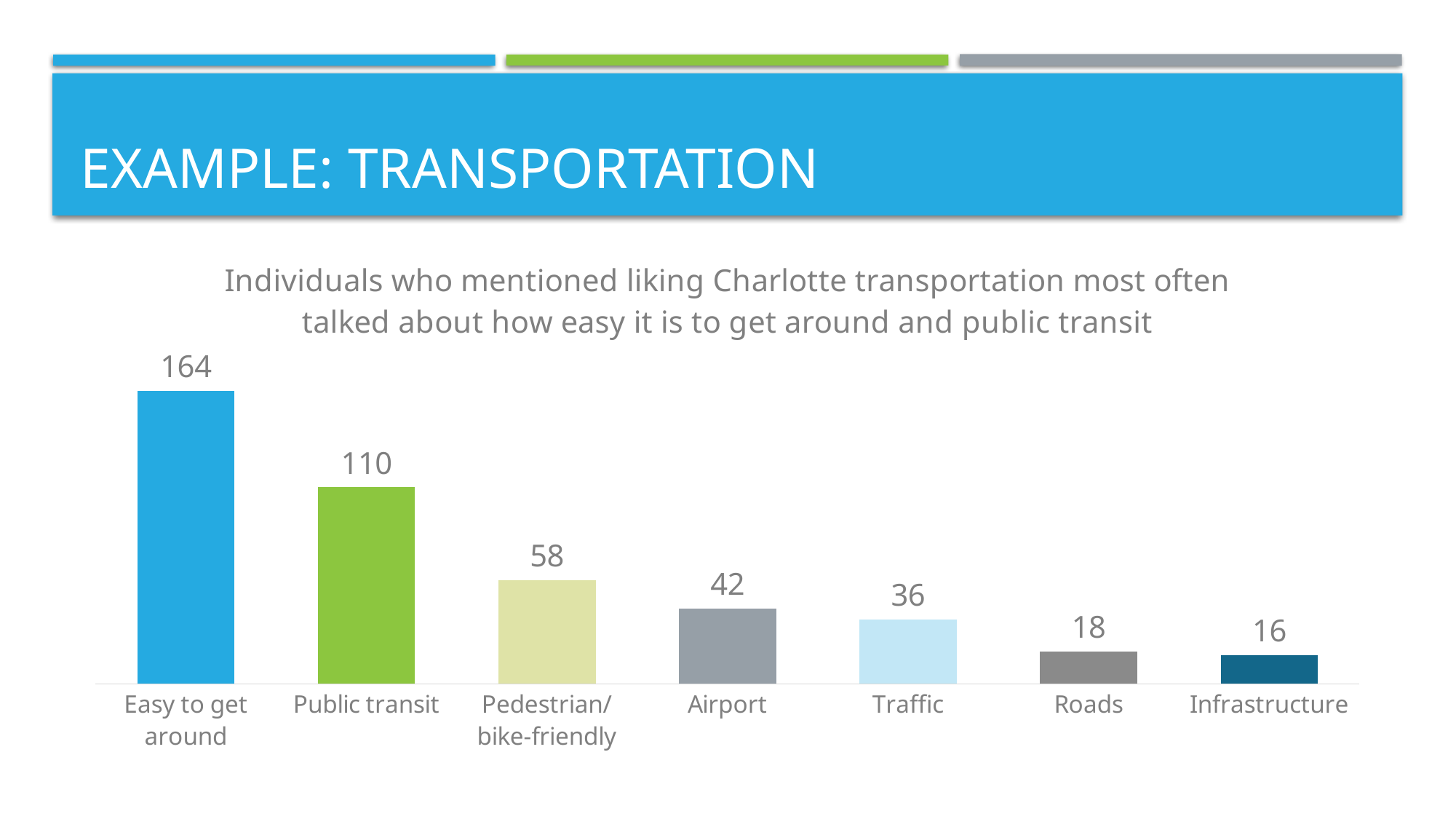
What is the value for Public transit? 110 What is the difference between the values for Easy to get around and Public transit? 54 What kind of chart is shown on the slide? Bar chart What is the value for Pedestrian/bike-friendly? 58 Which category has the highest value? Easy to get around What is the value for Easy to get around? 164 What is the value for Traffic? 36 What is the difference between the values for Airport and Roads? 24 How many categories are shown in the chart? 7 Which is larger, the value for Airport or the value for Traffic? Airport Which category has the lowest value? Infrastructure Do the values rise or fall from left to right across the categories? Fall